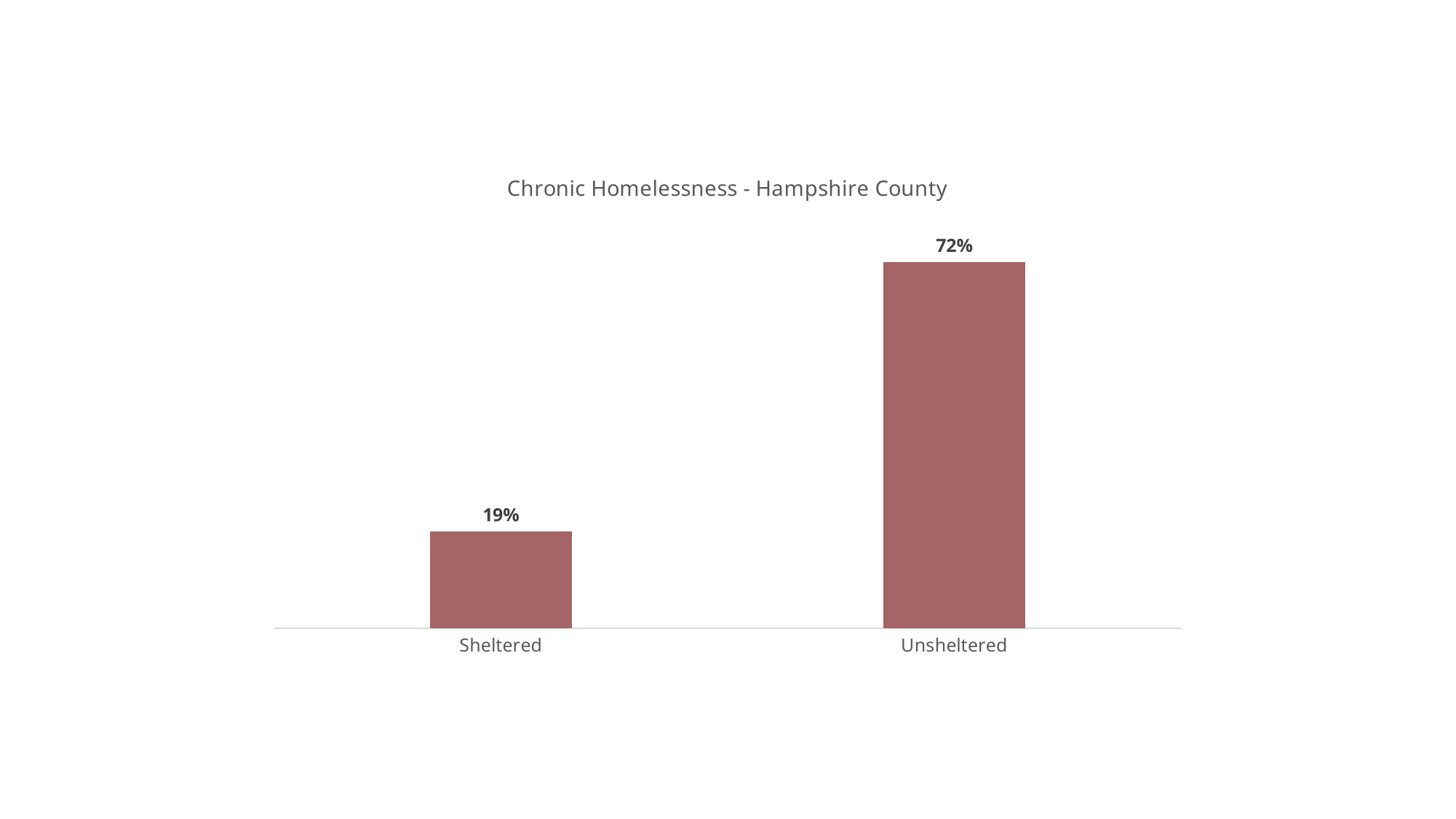
Which is larger, the value for Sheltered or the value for Unsheltered? Unsheltered Do the values rise or fall from Sheltered to Unsheltered? Rise How many categories are shown on the chart? 2 What colour are the bars in the chart? Reddish brown What is the value for Sheltered? 19% What is the title of the chart? Chronic Homelessness - Hampshire County Which category has the highest value? Unsheltered What kind of chart is shown on the slide? Bar chart Which category has the lowest value? Sheltered What is the value for Unsheltered? 72% What is the difference between the Unsheltered and Sheltered values? 53%